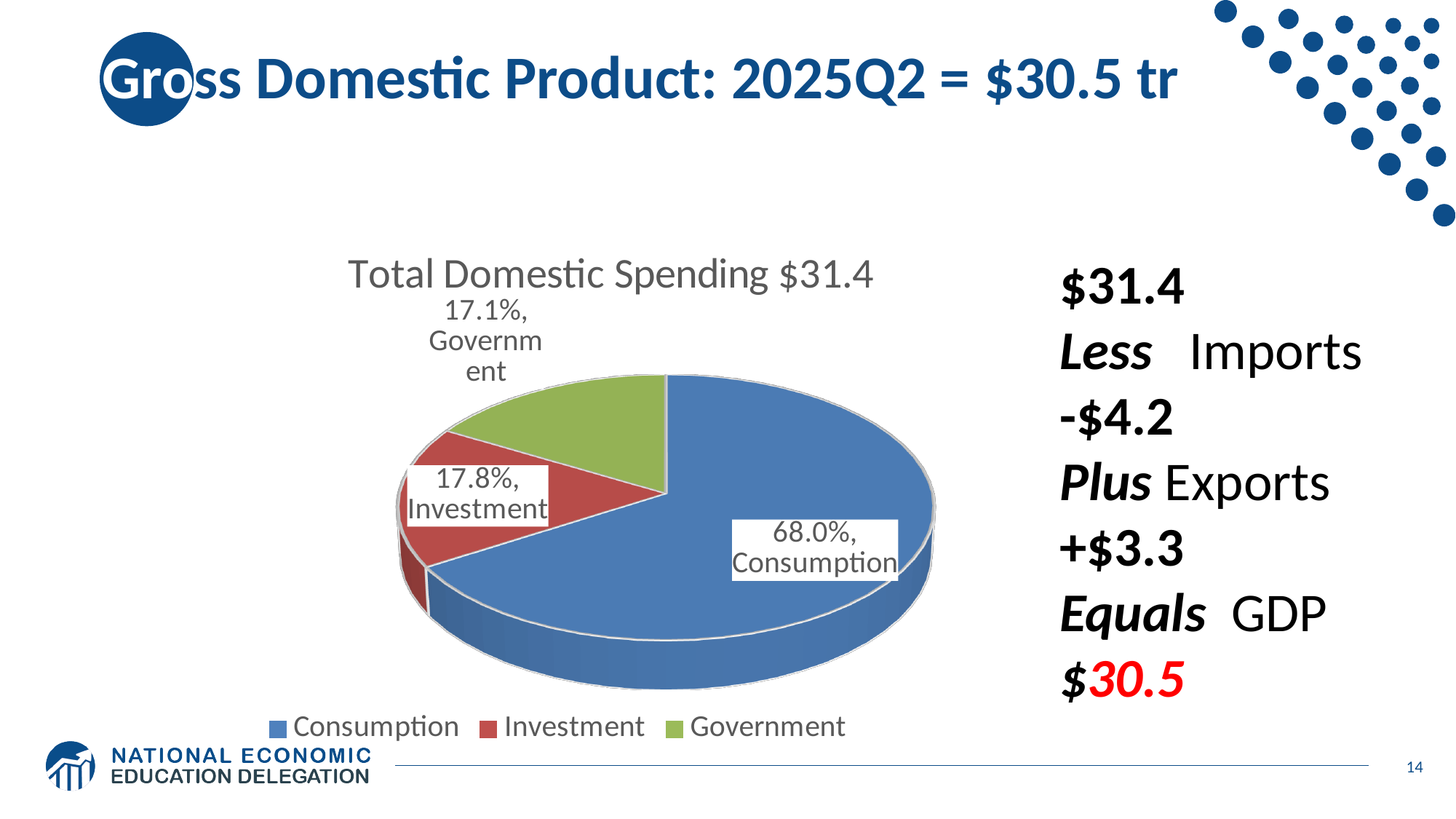
What is the difference in percentage points between the Investment and Government shares? 0.7 percentage points Which category has the largest slice of the pie? Consumption How many categories are shown in the pie chart? 3 What share of Total Domestic Spending does Consumption account for? 68.0% What is the title of the chart? Total Domestic Spending $31.4 How many entries does the legend list? 3 Which category has the smallest slice of the pie? Government What share of Total Domestic Spending does Investment account for? 17.8% Which is larger, the Consumption share or the Government share? Consumption What is the difference in percentage points between the Consumption and Investment shares? 50.2 percentage points What share of Total Domestic Spending does Government account for? 17.1% What kind of chart is shown on the slide? Pie chart